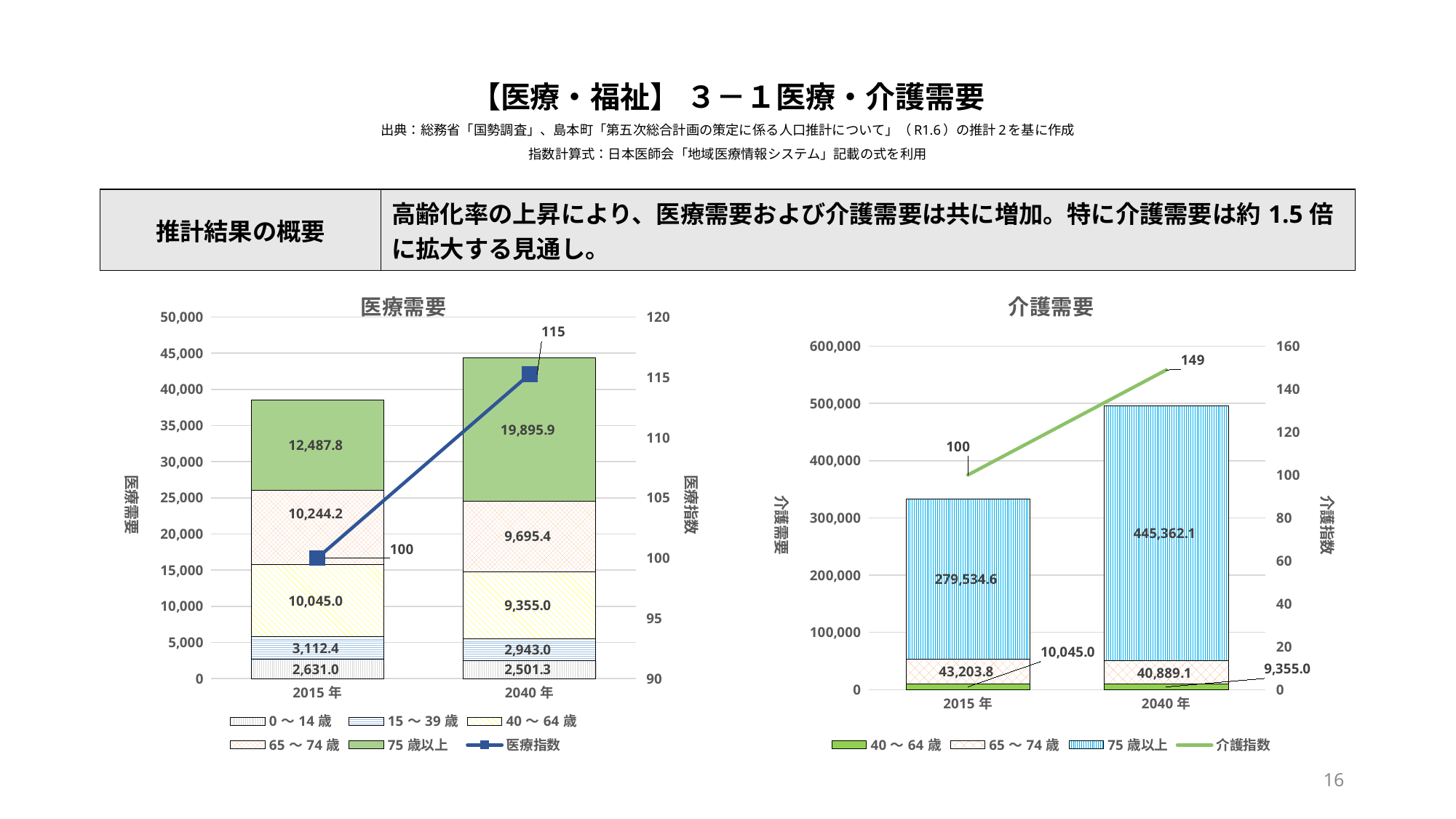
In the 医療需要 chart, which year has the larger 40～64歳 value, 2015年 or 2040年? 2015年 What kind of chart is the 介護需要 chart? stacked bar chart with a line In the 医療需要 chart, what is the difference between the 75歳以上 values for 2040年 and 2015年? 7,408.1 How many series does the legend of the 医療需要 chart list? 6 In the 医療需要 chart, what is the 医療指数 value for 2040年? 115 In the 介護需要 chart, which segment is the largest in the 2040年 bar? 75歳以上 In the 介護需要 chart, what is the total of the stacked bar for 2040年? 495,606.2 In the 介護需要 chart, what is the 介護指数 value for 2040年? 149 In the 医療需要 chart, what is the total of the stacked bar for 2015年? 38,520.4 In the 医療需要 chart, what is the value for 75歳以上 in 2040年? 19,895.9 In the 介護需要 chart, what is the value for 75歳以上 in 2015年? 279,534.6 In the 介護需要 chart, does the 介護指数 line rise or fall from 2015年 to 2040年? rise